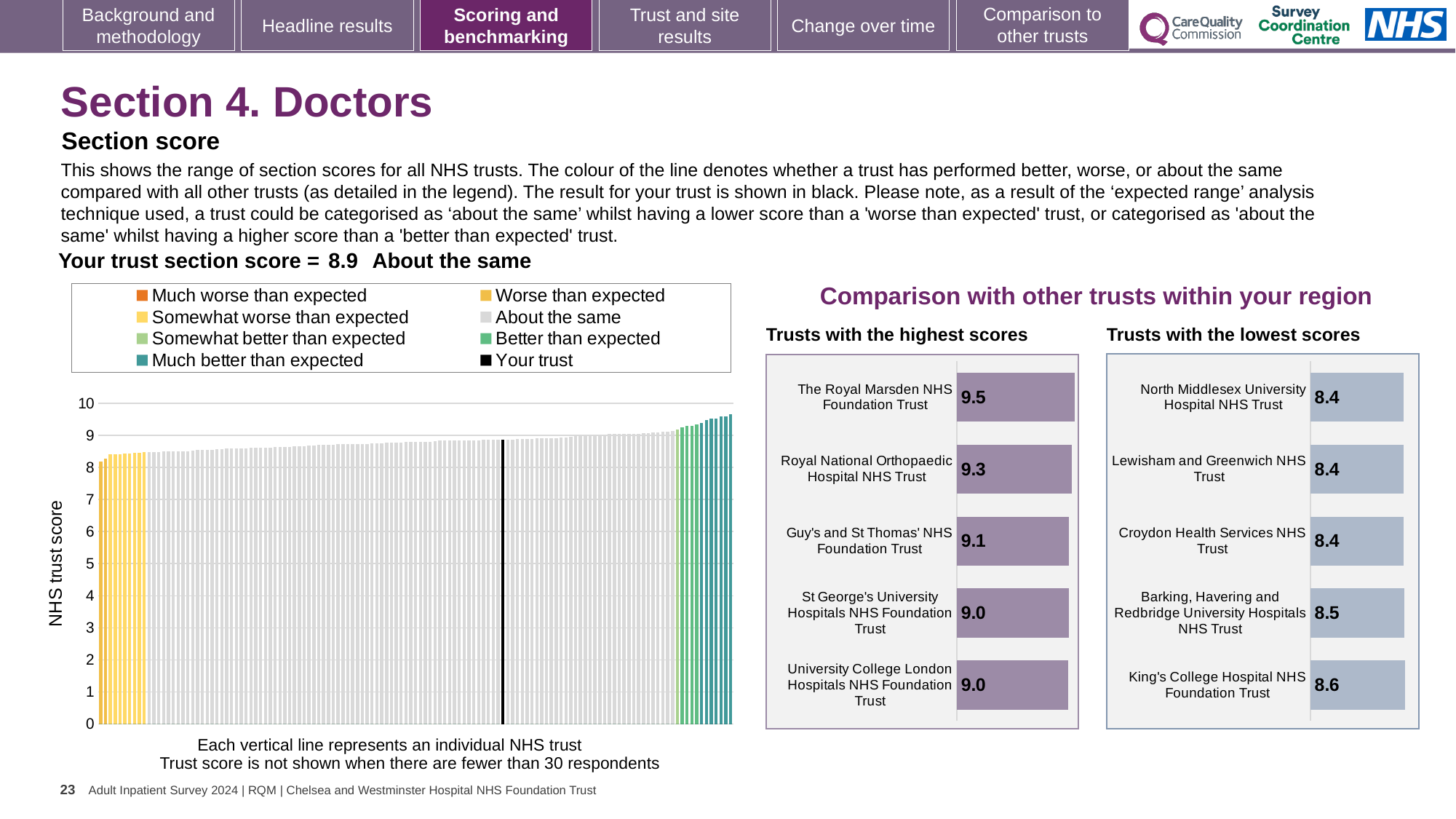
In the 'Trusts with the highest scores' chart, what is the score for The Royal Marsden NHS Foundation Trust? 9.5 What kind of chart is the large chart on the left showing NHS trust scores? bar chart In the large chart on the left, what is the label on the vertical axis? NHS trust score In the 'Trusts with the lowest scores' chart, what is the difference between the scores of King's College Hospital NHS Foundation Trust and North Middlesex University Hospital NHS Trust? 0.2 In the 'Trusts with the lowest scores' chart, which is larger: the score for King's College Hospital NHS Foundation Trust or the score for Croydon Health Services NHS Trust? King's College Hospital NHS Foundation Trust In the 'Trusts with the highest scores' chart, which trust has the highest score? The Royal Marsden NHS Foundation Trust In the 'Trusts with the lowest scores' chart, which trust has the highest score? King's College Hospital NHS Foundation Trust In the 'Trusts with the highest scores' chart, what is the difference between the scores of The Royal Marsden NHS Foundation Trust and Royal National Orthopaedic Hospital NHS Trust? 0.2 In the large chart on the left, is the value for your trust (the black line) greater or less than 8? greater How many trusts are shown in the 'Trusts with the highest scores' chart? 5 In the 'Trusts with the lowest scores' chart, what is the score for Barking, Havering and Redbridge University Hospitals NHS Trust? 8.5 How many entries does the legend above the large chart on the left list? 8